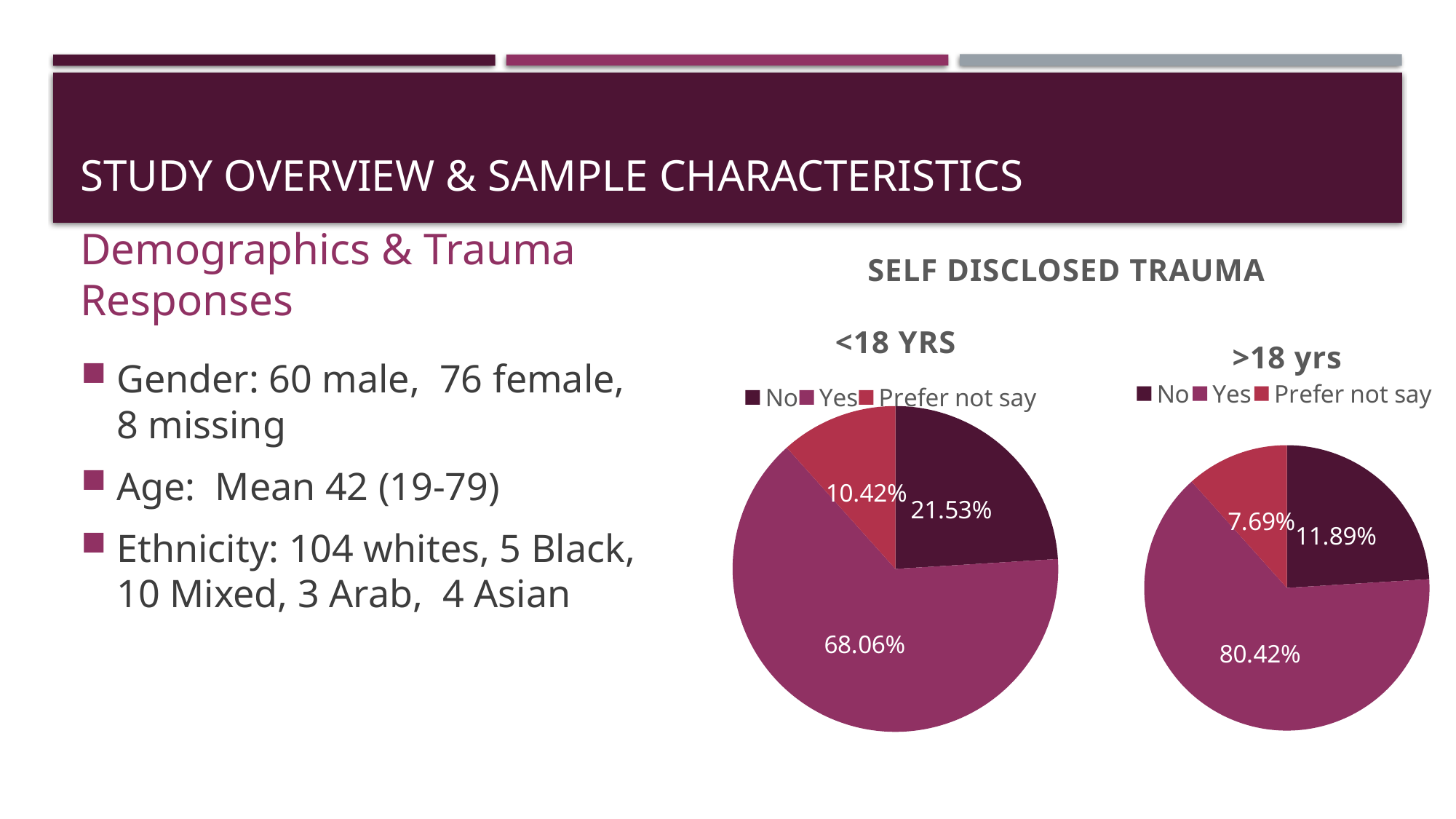
What type of chart is used for the '<18 YRS' data? Pie chart Which is larger: the 'No' share in the '<18 YRS' chart or the 'No' share in the '>18 yrs' chart? <18 YRS In the '<18 YRS' pie chart, what percentage is shown for 'Yes'? 68.06% What is the difference between the 'Yes' share in the '>18 yrs' chart and the 'Yes' share in the '<18 YRS' chart? 12.36% How many categories does the legend of the '>18 yrs' pie chart list? 3 In the '<18 YRS' pie chart, which category has the largest share? Yes In the '<18 YRS' pie chart, what percentage is shown for 'Prefer not say'? 10.42% In the '>18 yrs' pie chart, which category has the smallest share? Prefer not say In the '>18 yrs' pie chart, what percentage is shown for 'Yes'? 80.42% In the '>18 yrs' pie chart, what percentage is shown for 'Prefer not say'? 7.69% In the '<18 YRS' pie chart, what percentage is shown for 'No'? 21.53% In the '>18 yrs' pie chart, what percentage is shown for 'No'? 11.89%